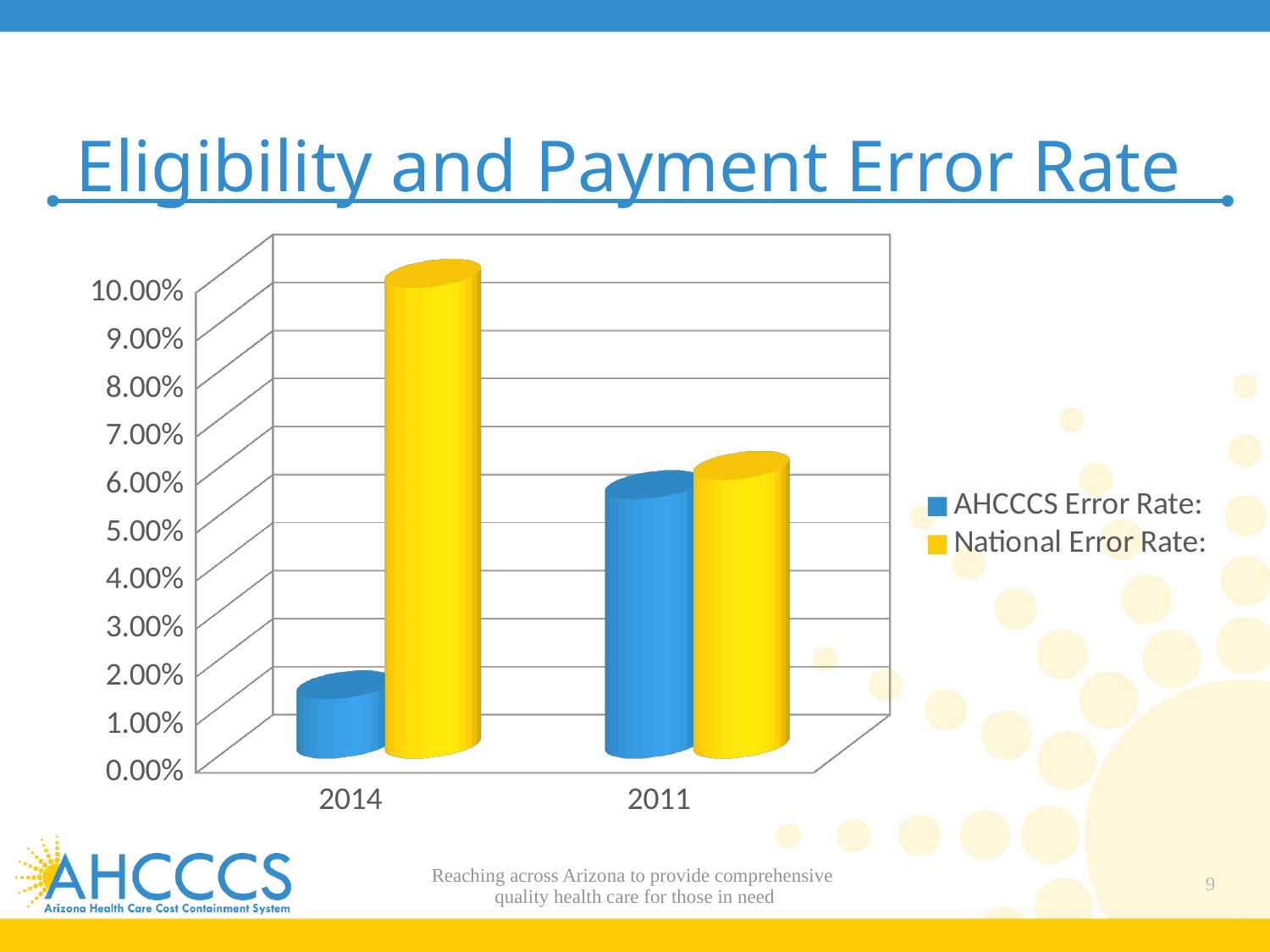
Which bar is the shortest in the chart? AHCCCS Error Rate for 2014 Is the National Error Rate for 2011 greater or less than 7.00%? less Is the National Error Rate for 2014 greater or less than 9.00%? greater What is the title of the slide? Eligibility and Payment Error Rate Which bar is the tallest in the chart? National Error Rate for 2014 What type of chart is shown on the slide? Bar chart How many categories are shown on the x axis? 2 For 2014, which is larger: the AHCCCS Error Rate or the National Error Rate? National Error Rate Which colour represents the National Error Rate in the legend? Yellow How many series does the legend list? 2 Is the AHCCCS Error Rate for 2014 greater or less than 2.00%? less